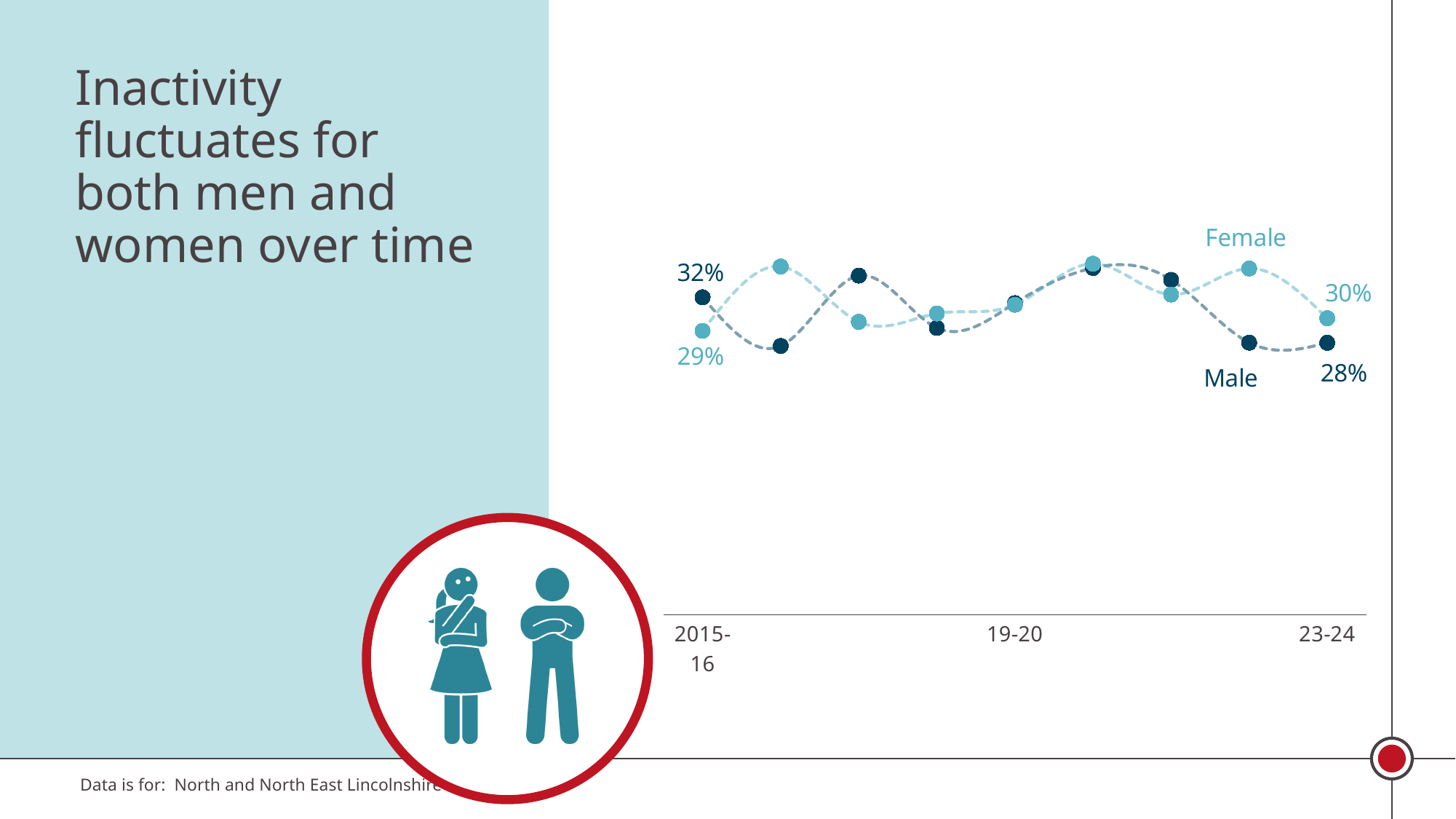
What is the Male inactivity value for 2015-16? 32% What is the Female inactivity value for 2015-16? 29% In 2015-16, which series has the higher value, Male or Female? Male What is the title of the slide containing the chart? Inactivity fluctuates for both men and women over time In 23-24, which series has the higher value, Male or Female? Female Did the Male value rise or fall between 2015-16 and 23-24? Fall What is the difference between the Male values for 2015-16 and 23-24? 4 percentage points What kind of chart is shown on the slide? Line chart What is the difference between the Male and Female values in 2015-16? 3 percentage points What is the Female inactivity value for 23-24? 30% What is the Male inactivity value for 23-24? 28% How many series are plotted on the chart? 2